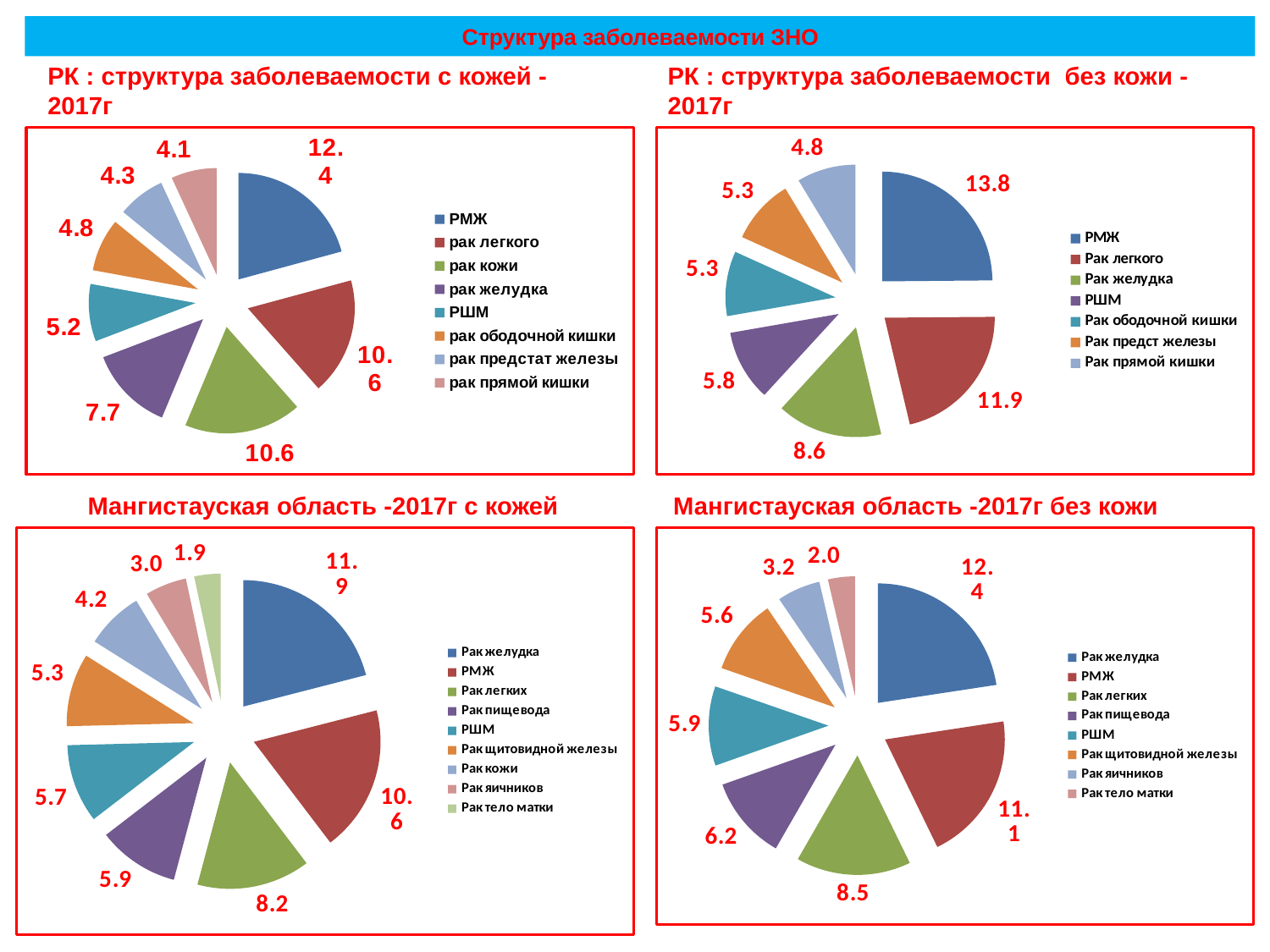
In the chart 'Мангистауская область -2017г без кожи', which is larger: the value for РШМ or the value for Рак пищевода? Рак пищевода In the chart 'РК : структура заболеваемости без кожи - 2017г', what is the difference between the values for РМЖ and Рак легкого? 1.9 How many entries does the legend of the chart 'Мангистауская область -2017г с кожей' list? 9 In the chart 'РК : структура заболеваемости с кожей - 2017г', what is the value for РМЖ? 12.4 What type of chart is 'РК : структура заболеваемости с кожей - 2017г'? Pie chart In the chart 'Мангистауская область -2017г без кожи', what is the difference between the values for Рак желудка and РМЖ? 1.3 In the chart 'Мангистауская область -2017г с кожей', what is the value for Рак щитовидной железы? 5.3 In the chart 'РК : структура заболеваемости с кожей - 2017г', what is the value for рак прямой кишки? 4.1 In the chart 'Мангистауская область -2017г с кожей', which category has the smallest value? Рак тело матки In the chart 'РК : структура заболеваемости без кожи - 2017г', what is the value for Рак желудка? 8.6 In the chart 'Мангистауская область -2017г без кожи', which category has the largest value? Рак желудка How many categories does the chart 'РК : структура заболеваемости без кожи - 2017г' show? 7